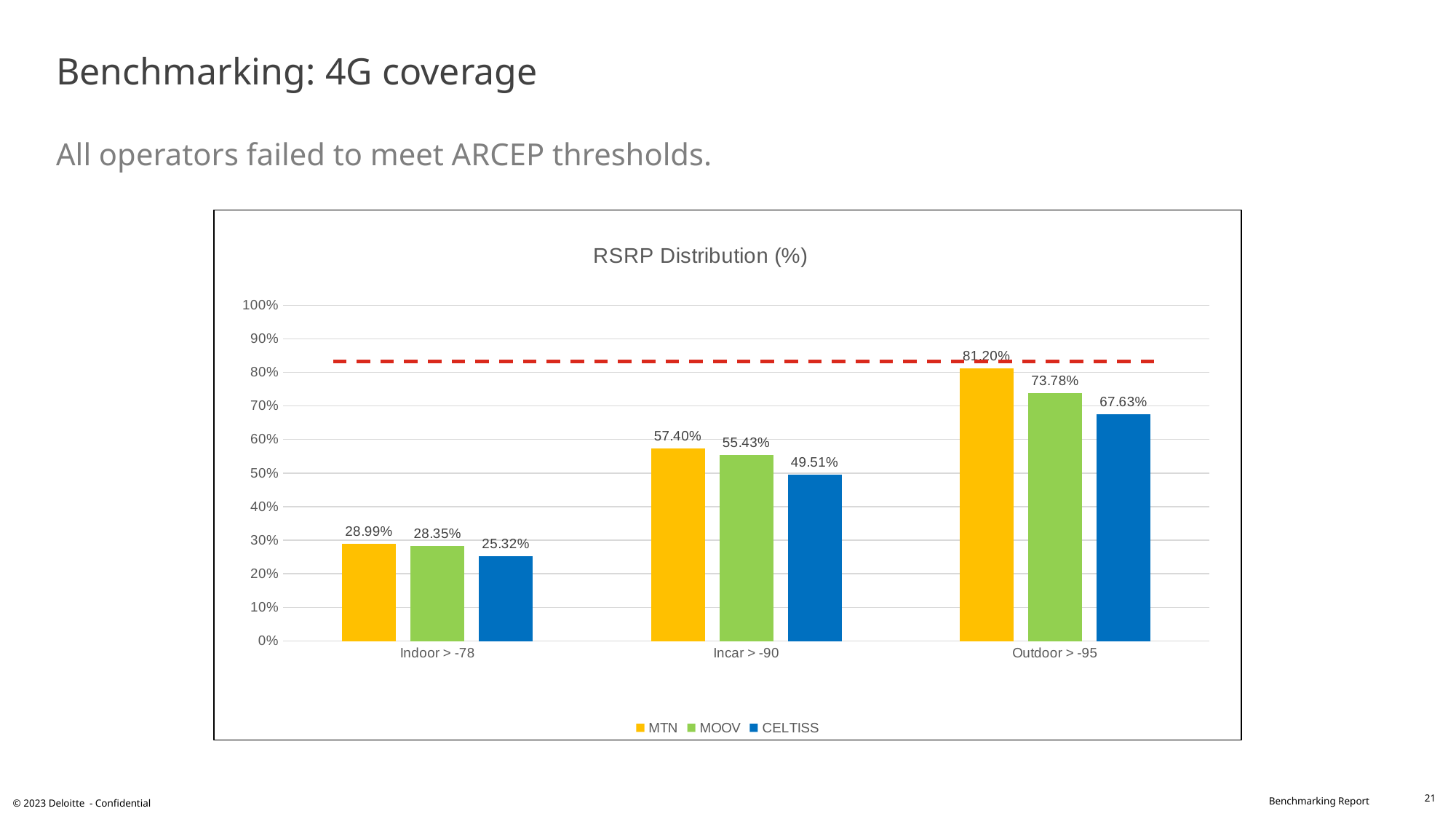
What is the title of the chart? RSRP Distribution (%) Is the value for CELTISS in the Outdoor > -95 category greater or less than 60%? greater What is the difference between MTN and CELTISS in the Outdoor > -95 category? 13.57% Which operator has the lowest value in the Indoor > -78 category? CELTISS What is the value for CELTISS in the Incar > -90 category? 49.51% How many series does the legend list? 3 What is the value for MTN in the Indoor > -78 category? 28.99% Which is larger in the Incar > -90 category: MTN or MOOV? MTN What kind of chart is shown on the slide? Bar chart What is the value for MOOV in the Outdoor > -95 category? 73.78% How many categories are shown on the x axis? 3 Which operator has the highest value in the Outdoor > -95 category? MTN